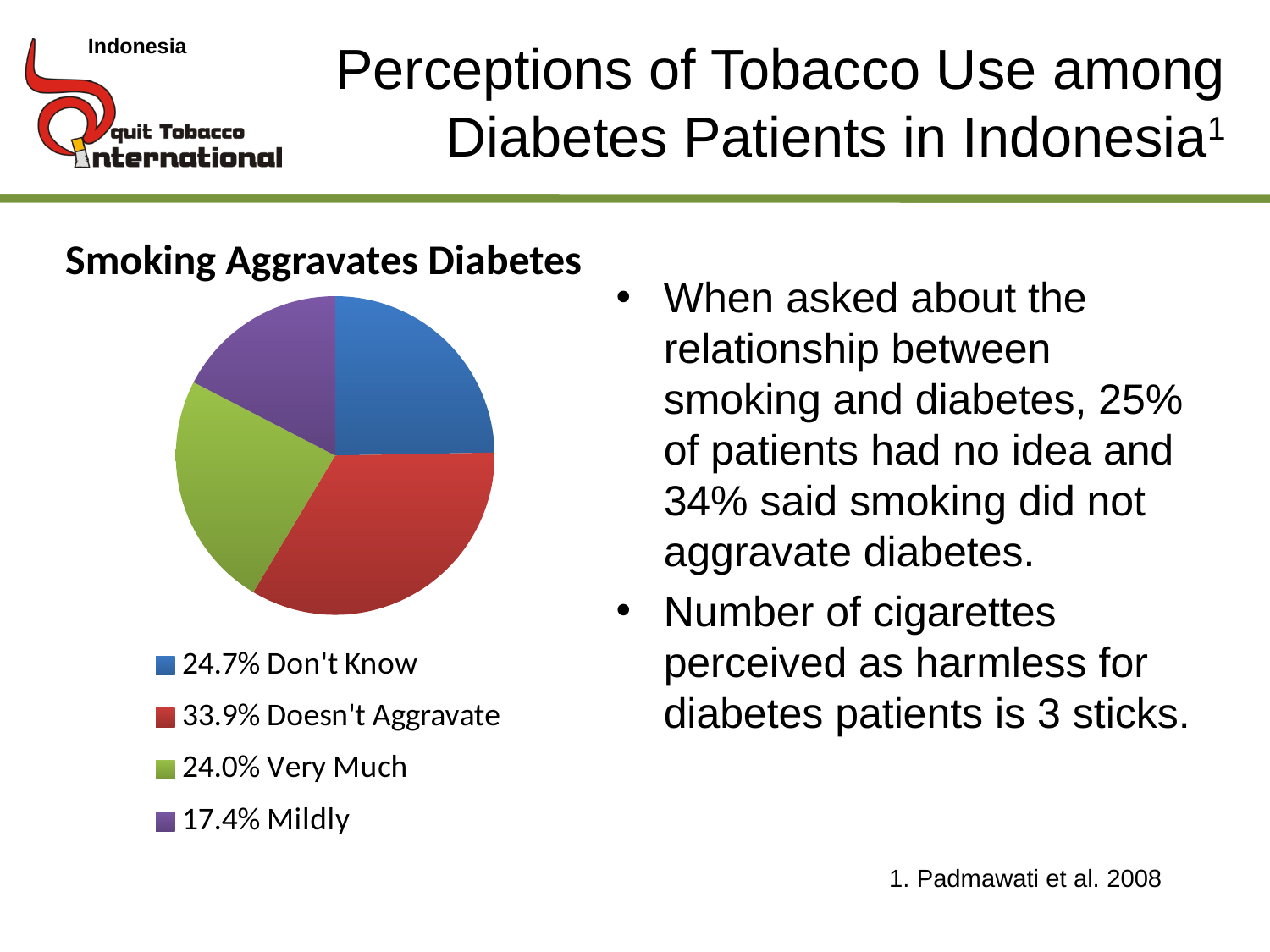
Which category has the largest slice of the pie? Doesn't Aggravate What percentage is shown for "Doesn't Aggravate"? 33.9% What is the difference in percentage points between "Doesn't Aggravate" and "Mildly"? 16.5 Which is larger, the "Doesn't Aggravate" slice or the "Mildly" slice? Doesn't Aggravate What kind of chart is shown on the slide? Pie chart What percentage is shown for "Very Much"? 24.0% What is the title of the chart? Smoking Aggravates Diabetes What share of the pie is the "Don't Know" slice? 24.7% What percentage is shown for "Mildly"? 17.4% How many slices does the pie chart have? 4 Which category has the smallest slice of the pie? Mildly What colour is the "Mildly" slice in the pie chart? Purple